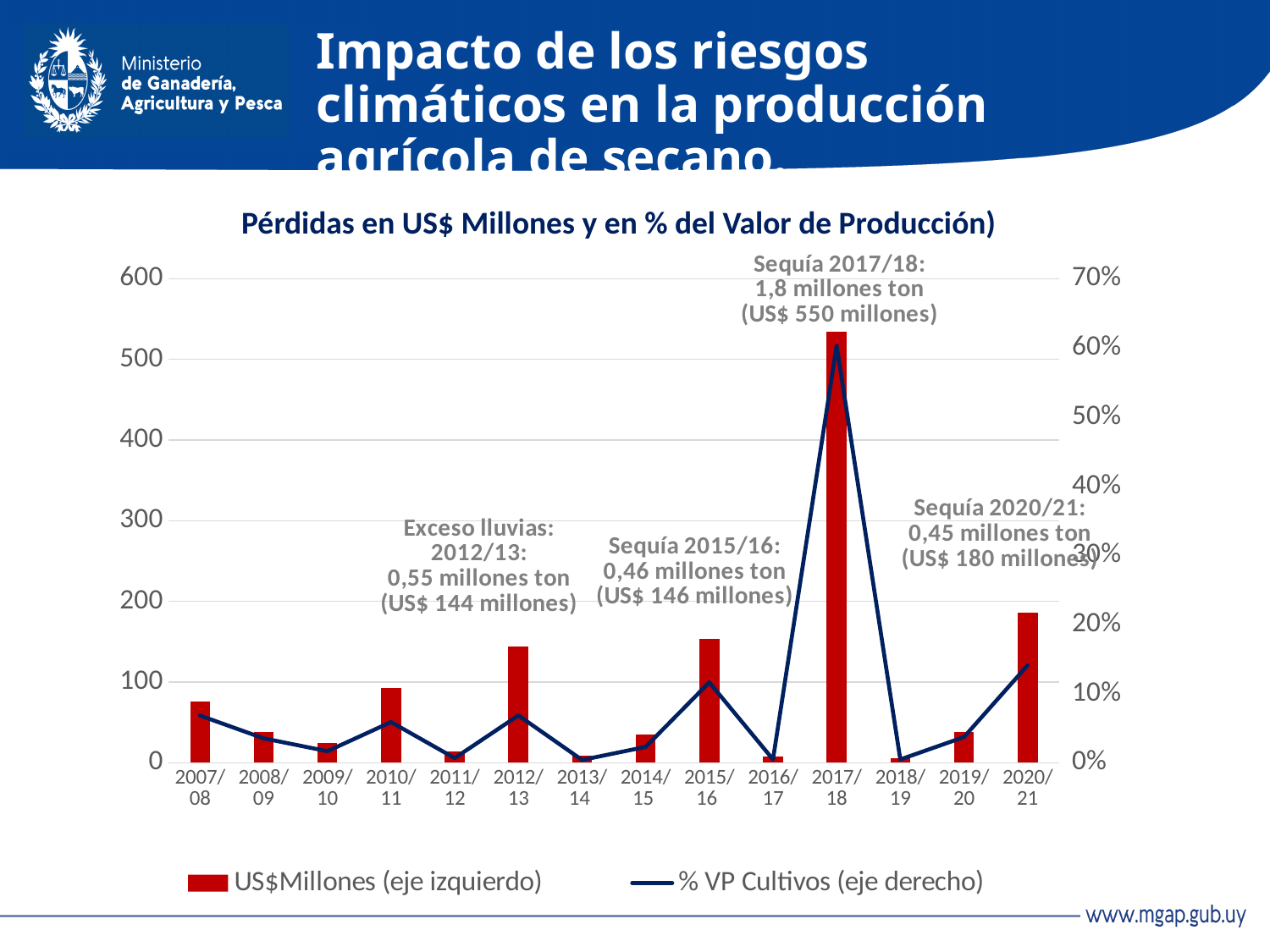
Is the US$ millions value for 2007/08 greater or less than 100? less Which season has the highest loss in US$ millions? 2017/18 According to the annotation, what was the loss in US$ millions for the 2020/21 drought? US$ 180 millones What is the difference in US$ millions between the 2017/18 loss and the 2020/21 loss, using the annotated values? 370 Is the % VP Cultivos value for 2017/18 greater or less than 50%? greater What kind of chart is shown on the slide? A combined bar and line chart Which is larger, the US$ millions loss in 2017/18 or in 2020/21? 2017/18 How many series does the legend list? 2 According to the annotation, what was the loss in US$ millions for the 2017/18 drought? US$ 550 millones How many seasons (categories) are shown on the x axis? 14 According to the annotation, what was the loss in US$ millions for the 2012/13 excess rainfall event? US$ 144 millones What is the title of the chart? Pérdidas en US$ Millones y en % del Valor de Producción)